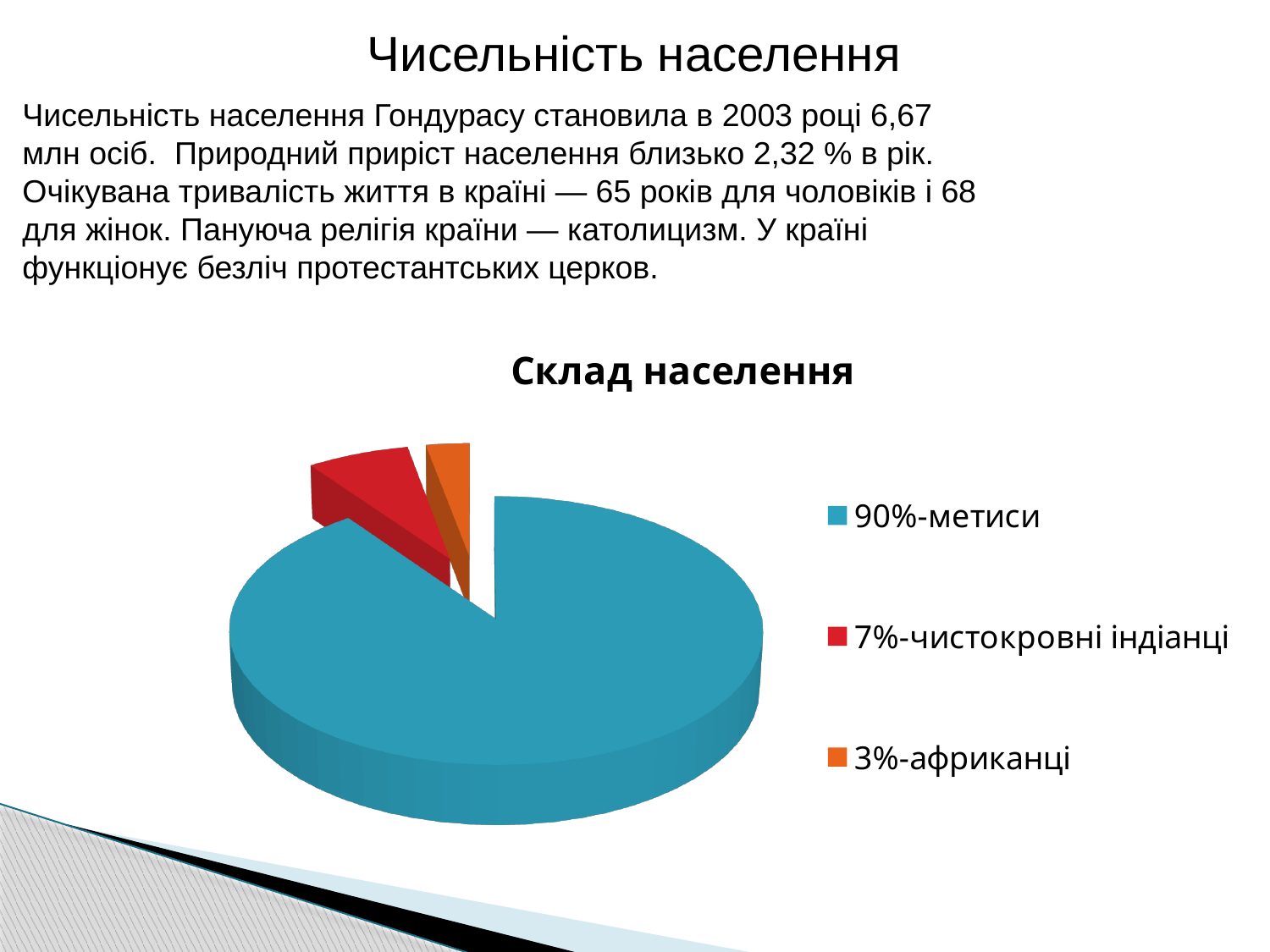
How many entries does the legend of the pie chart list? 3 What share of the population do чистокровні індіанці make up according to the pie chart? 7% Which group has the largest slice in the pie chart? метиси What share of the population do метиси make up according to the pie chart? 90% What kind of chart is shown under the title "Склад населення"? pie chart Which slice is larger: чистокровні індіанці or африканці? чистокровні індіанці How many slices does the pie chart have? 3 What colour is the slice for метиси in the pie chart? blue What is the difference in percentage points between the share of метиси and the share of чистокровні індіанці? 83 Which group has the smallest slice in the pie chart? африканці What share of the population do африканці make up according to the pie chart? 3% What is the title of the chart on the slide? Склад населення